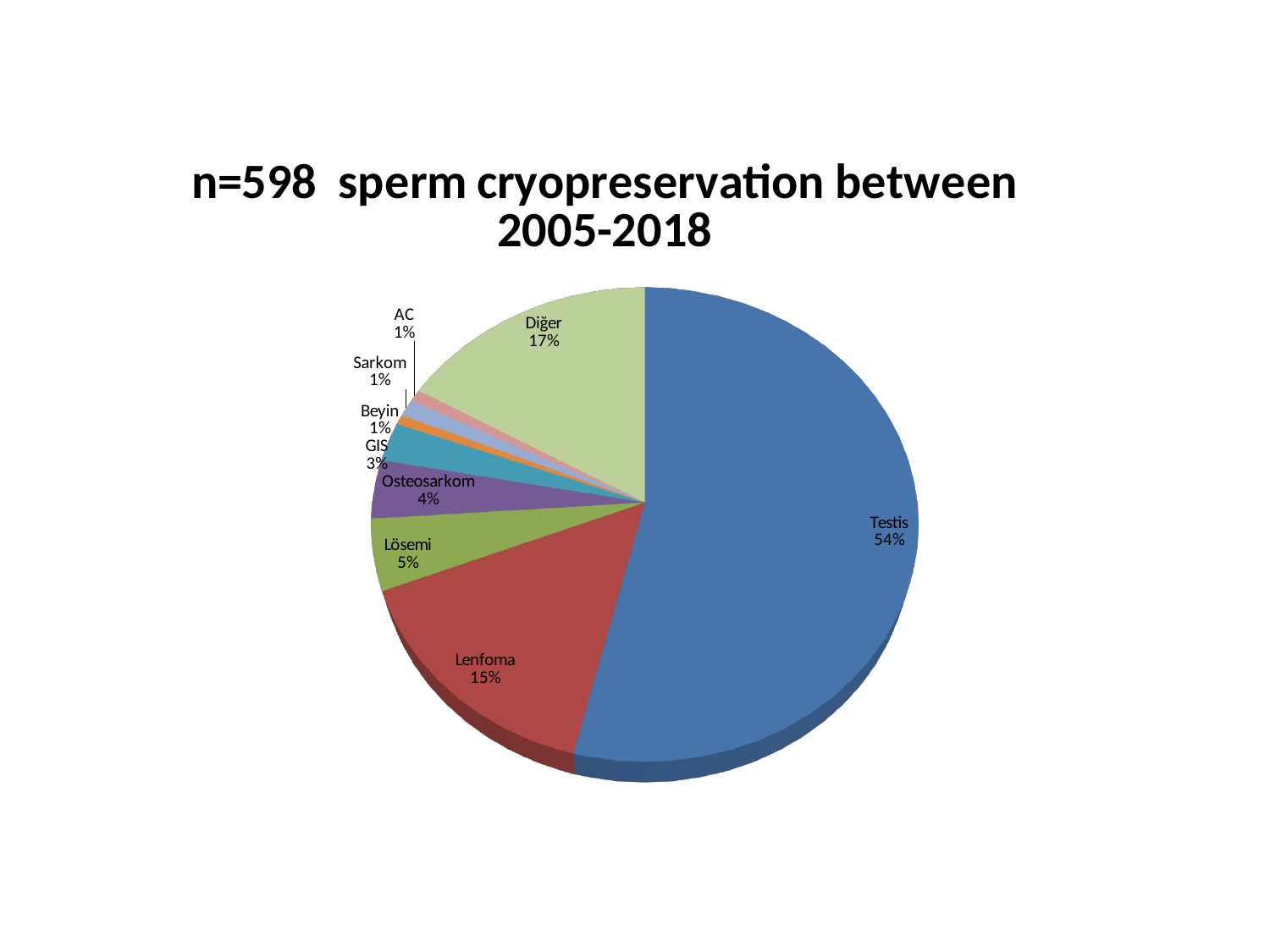
What percentage is shown for Lenfoma? 15% What share of the pie does Testis account for? 54% What percentage is shown for Osteosarkom? 4% What kind of chart is shown on the slide? Pie chart Which is larger, the share for Lösemi or the share for GIS? Lösemi Which is larger, the share for Diğer or the share for Lenfoma? Diğer What is the difference in percentage points between Testis and Lösemi? 49 How many categories are shown in the pie chart? 9 What is the title of the chart? n=598 sperm cryopreservation between 2005-2018 What percentage is shown for Diğer? 17% Which category has the largest slice of the pie? Testis What is the difference in percentage points between Diğer and Lenfoma? 2